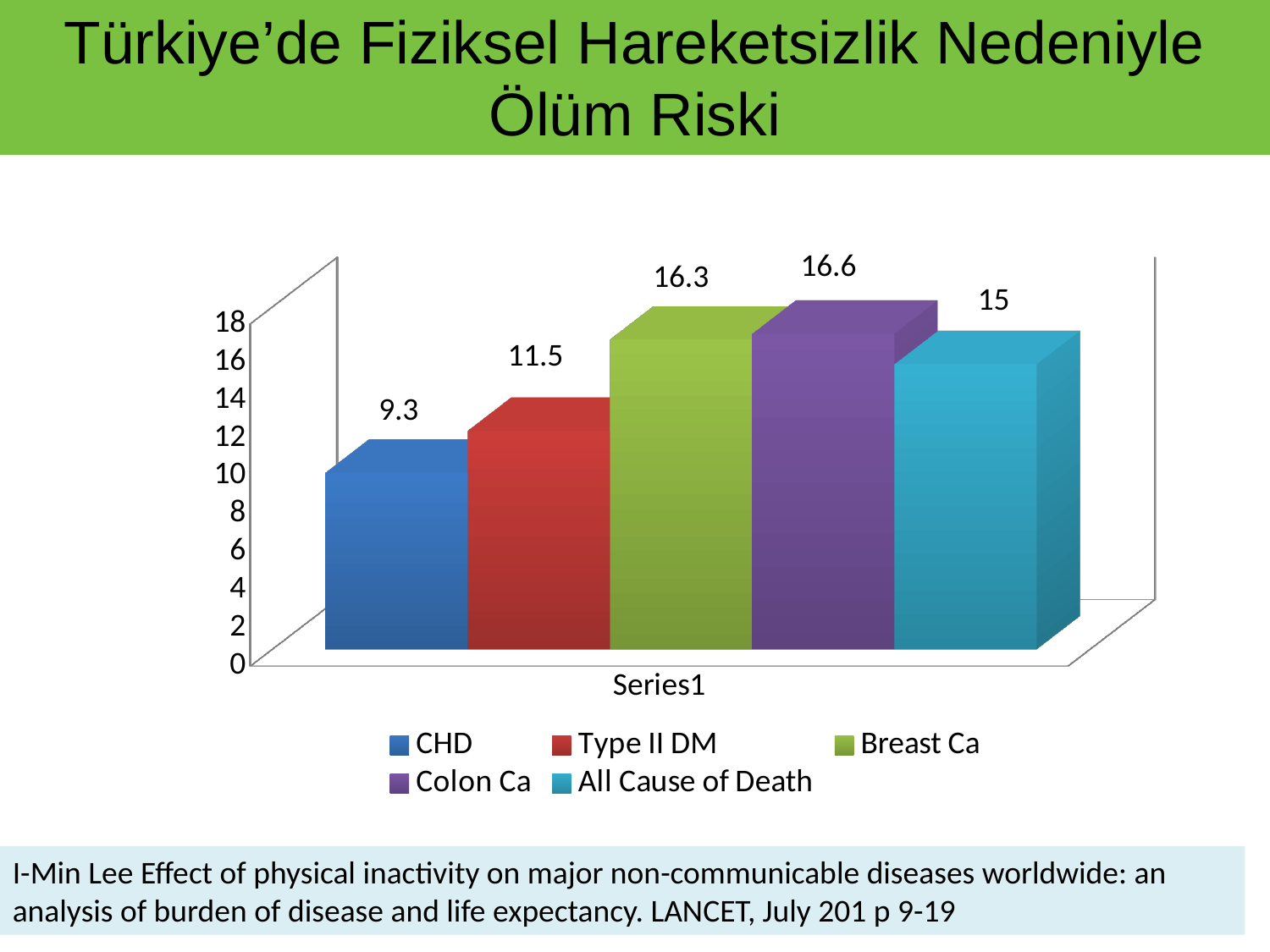
How many series does the legend list? 5 What is the difference between the values for Breast Ca and Type II DM? 4.8 What is the value for Type II DM? 11.5 Which series has the lowest value? CHD What is the difference between the values for Colon Ca and CHD? 7.3 What is the category label shown on the x axis? Series1 What is the value for All Cause of Death? 15 Which is larger, the value for All Cause of Death or the value for Type II DM? All Cause of Death What is the value for CHD? 9.3 What kind of chart is shown on the slide? Bar chart What is the value for Breast Ca? 16.3 Which series has the highest value? Colon Ca